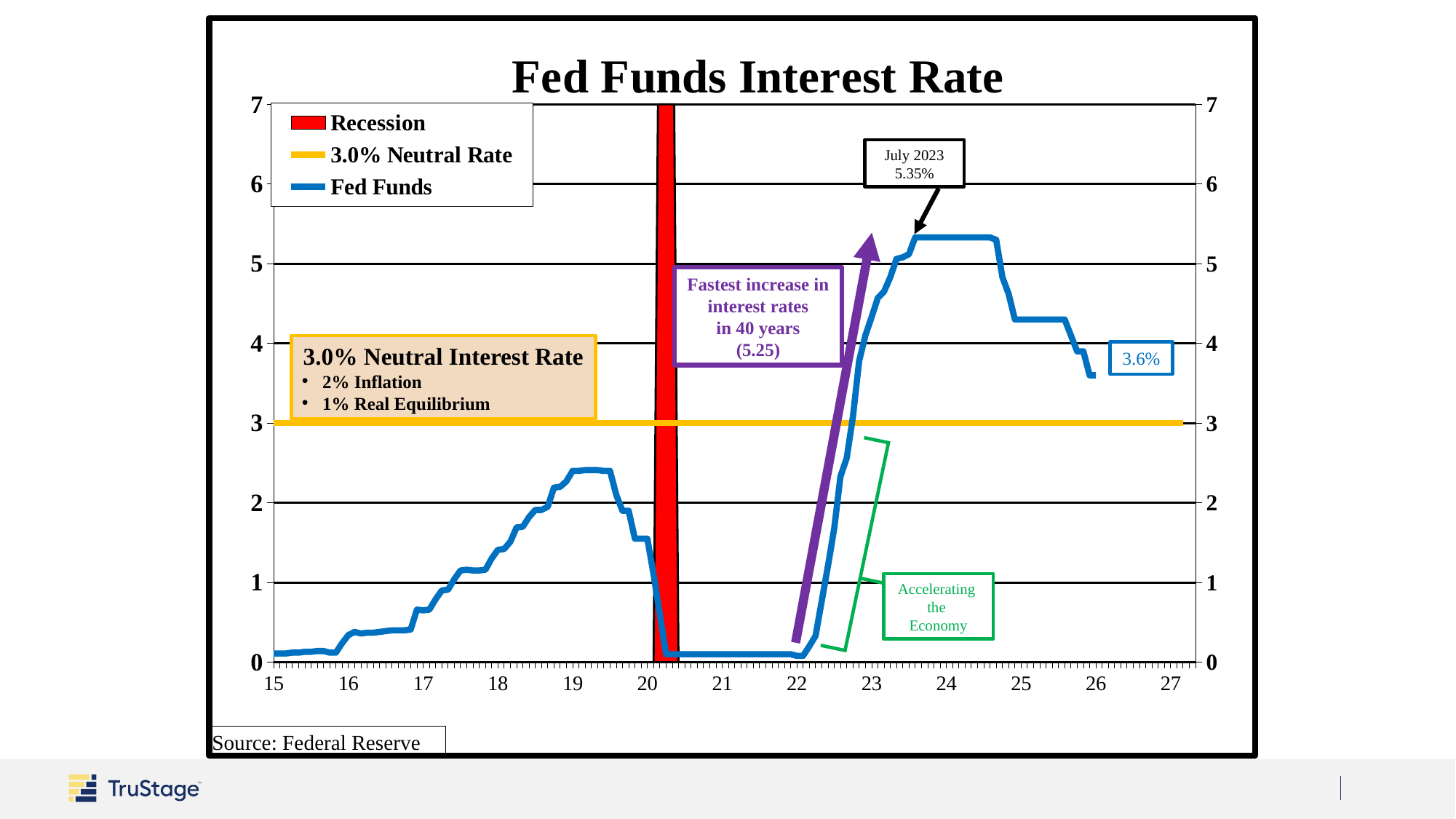
Is the Fed Funds rate at the start of 2025 greater or less than 4? greater What is the title of the chart? Fed Funds Interest Rate According to the annotation, how large was the fastest increase in interest rates in 40 years? 5.25 What Fed Funds rate is labelled at the end of the blue line, around 2026? 3.6% What value is the neutral interest rate line drawn at? 3.0% How many entries does the chart's legend list? 3 Does the Fed Funds line rise or fall between 2022 and 2023? rise Is the Fed Funds rate in 2021 greater or less than 1? less Which is higher: the Fed Funds peak in 2019 or the peak in 2023? 2023 What is the difference between the July 2023 rate of 5.35% and the labelled end value of 3.6%? 1.75% What Fed Funds rate is labelled for July 2023? 5.35% What type of chart is shown on the slide? line chart